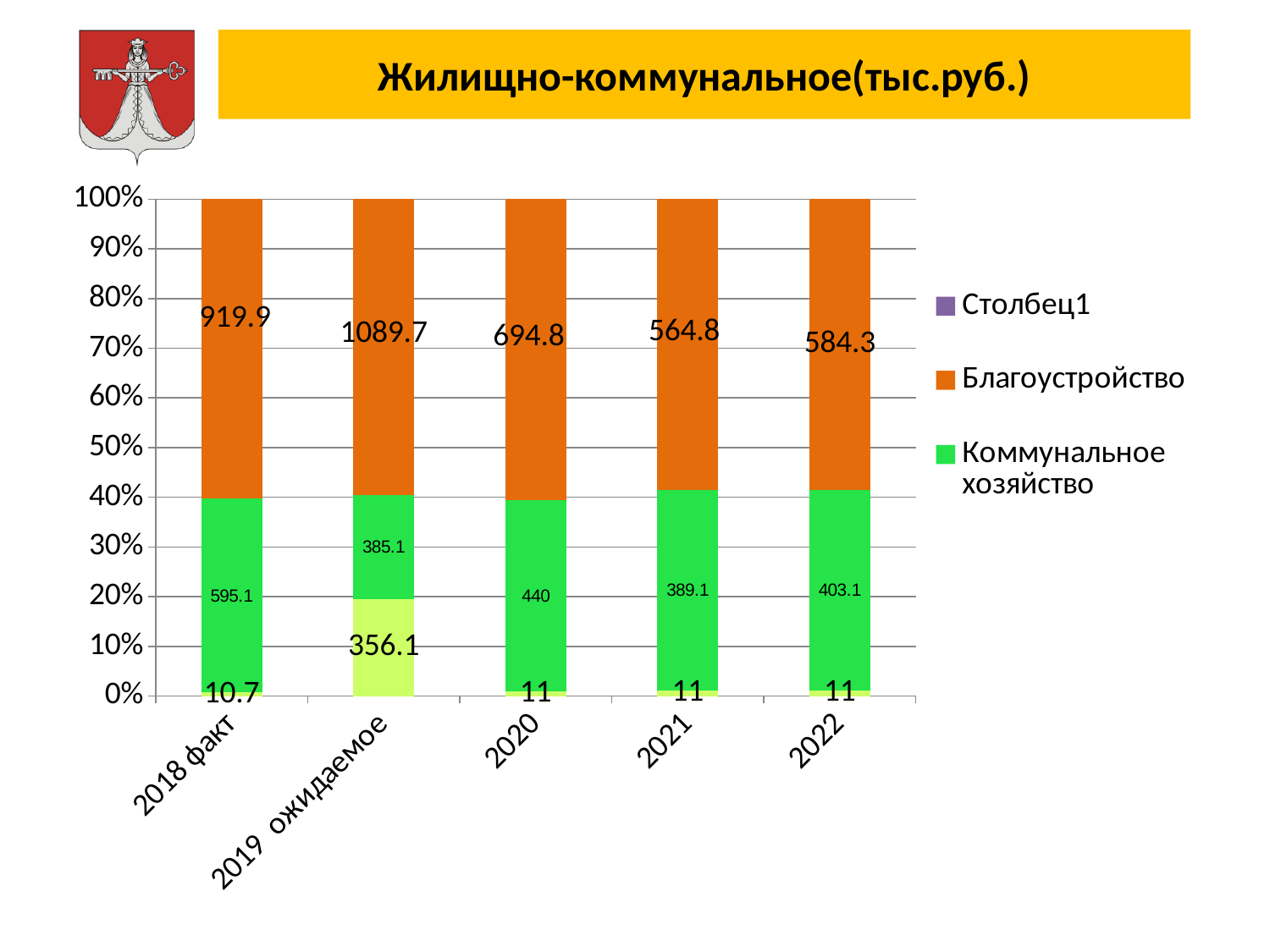
What is the value for Благоустройство in 2020? 694.8 In which category is the Коммунальное хозяйство value highest? 2018 факт How many series does the legend list? 3 What kind of chart is shown on the slide? Stacked bar chart How many categories are shown on the x axis? 5 In which category is the Благоустройство value highest? 2019 ожидаемое In which category is the Благоустройство value lowest? 2021 Which is larger, the Коммунальное хозяйство value for 2020 or for 2022? 2020 What is the difference between the Благоустройство values for 2018 факт and 2020? 225.1 What is the value for Коммунальное хозяйство in 2018 факт? 595.1 What is the title of the chart? Жилищно-коммунальное(тыс.руб.) What is the value of the bottom segment of the 2019 ожидаемое bar? 356.1